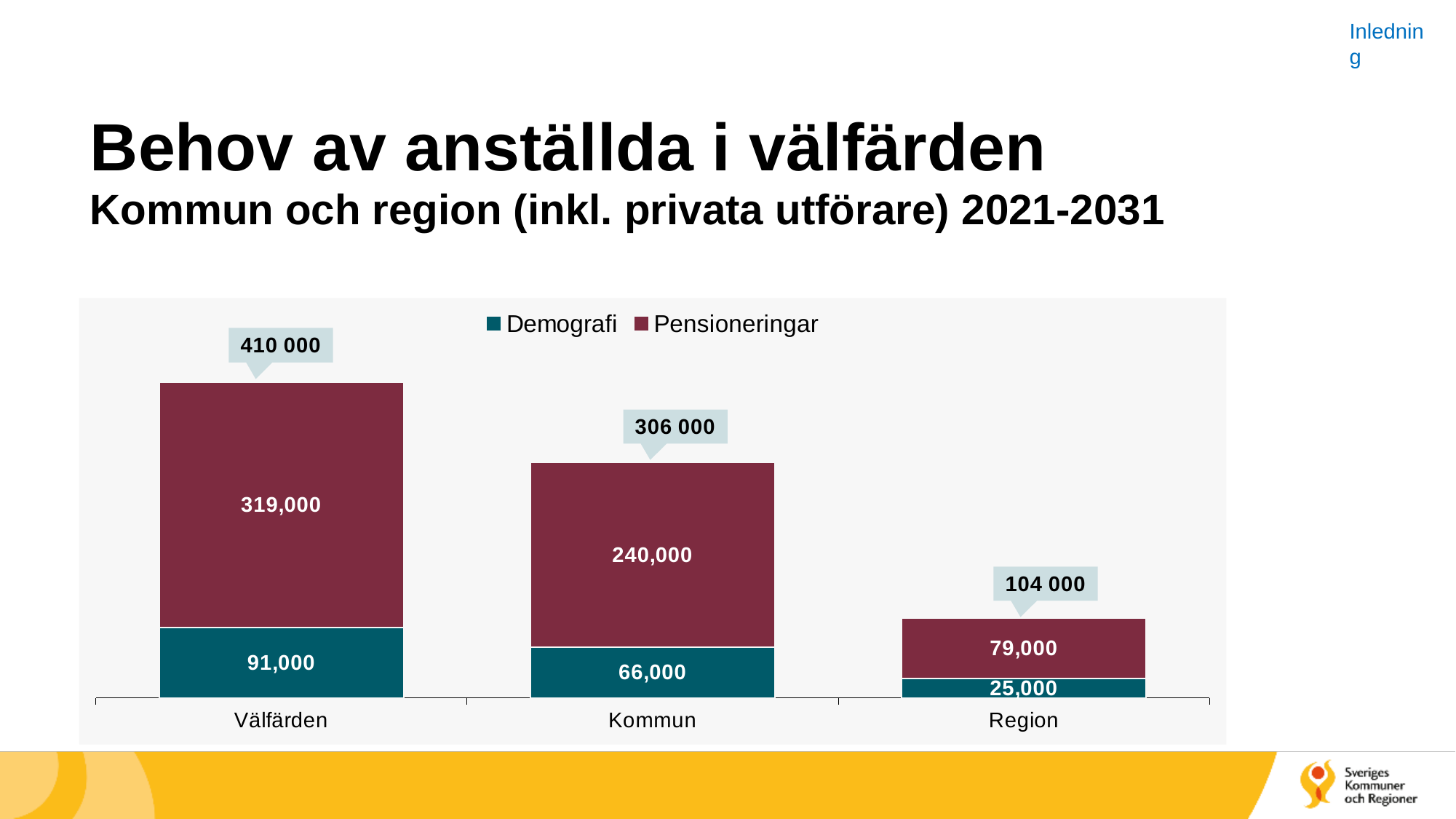
Which category has the lowest Demografi value? Region What is the Pensioneringar value for Kommun? 240,000 What kind of chart is shown on the slide? Stacked bar chart What is the Pensioneringar value for Region? 79,000 Which category has the highest total? Välfärden What is the Demografi value for Region? 25,000 Which is larger, the Demografi value for Kommun or the Pensioneringar value for Region? Pensioneringar for Region What is the difference between the Pensioneringar values for Välfärden and Kommun? 79,000 What is the total shown above the Kommun bar? 306 000 What is the total shown above the Välfärden bar? 410 000 What is the Demografi value for Välfärden? 91,000 How many series does the legend list? 2